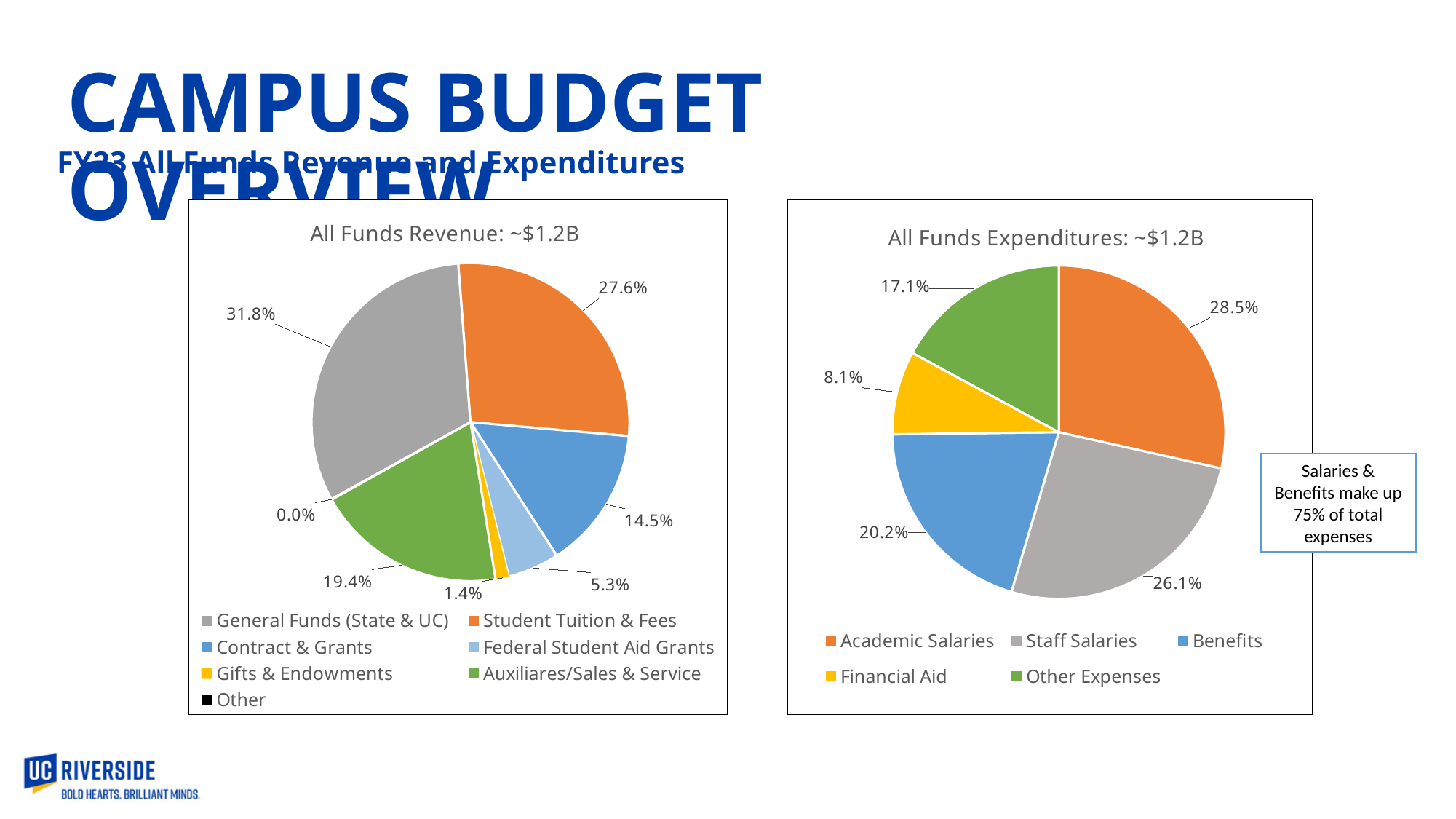
In the All Funds Revenue chart, which category has the largest share? General Funds (State & UC) In the All Funds Expenditures chart, which is larger, Staff Salaries or Benefits? Staff Salaries What colour represents Financial Aid in the All Funds Expenditures chart? Yellow In the All Funds Revenue chart, what is the difference between Contract & Grants and Federal Student Aid Grants? 9.2% In the All Funds Expenditures chart, which category has the smallest share? Financial Aid How many categories does the legend of the All Funds Revenue chart list? 7 What type of chart is used for All Funds Expenditures? Pie chart In the All Funds Revenue chart, what percentage is Student Tuition & Fees? 27.6% In the All Funds Expenditures chart, what is the difference between Benefits and Other Expenses? 3.1% In the All Funds Expenditures chart, what share is Academic Salaries? 28.5% In the All Funds Revenue chart, what share does General Funds (State & UC) make up? 31.8% In the All Funds Revenue chart, what is the percentage for Auxiliares/Sales & Service? 19.4%